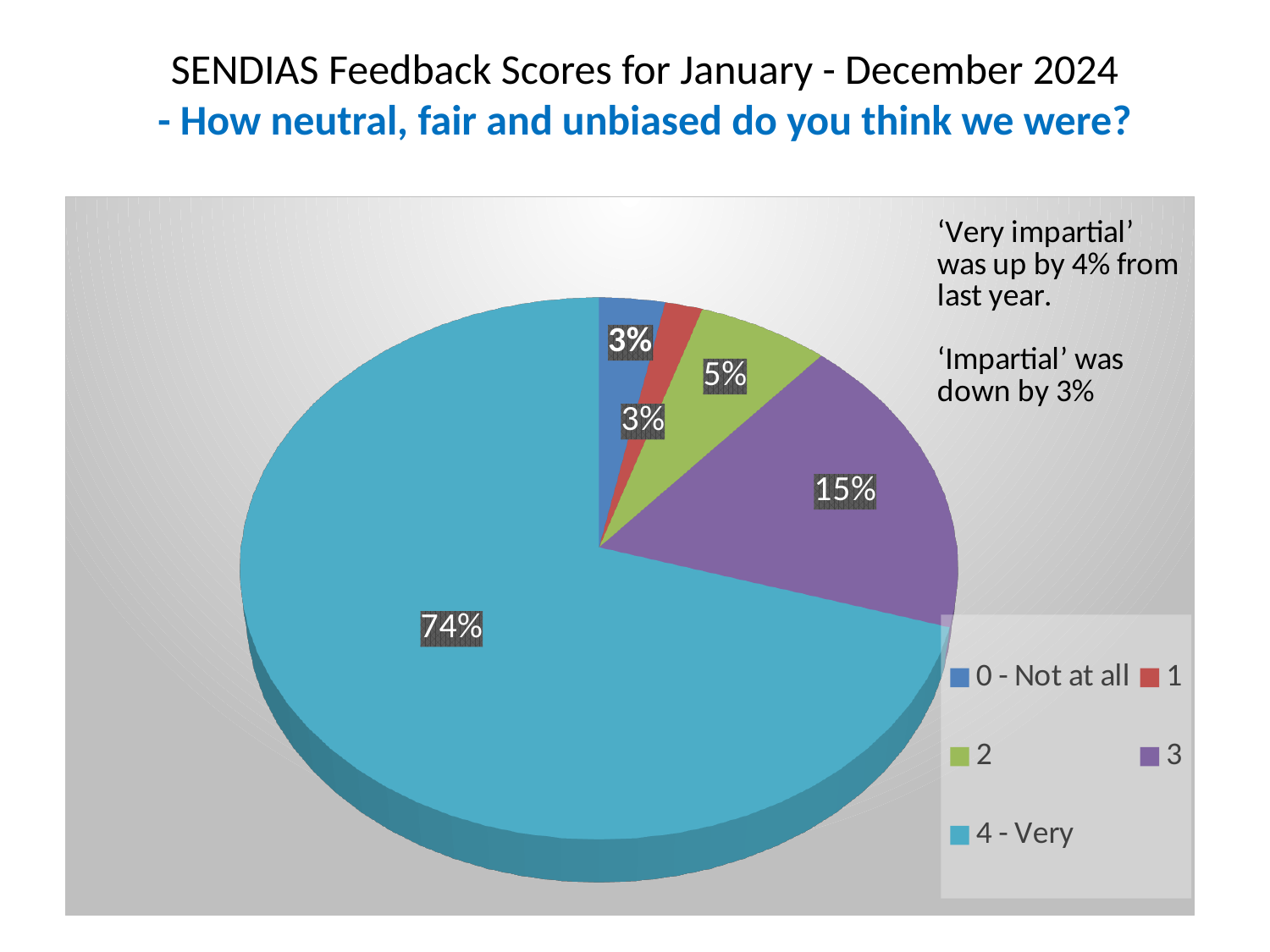
What kind of chart is shown on the slide? pie chart What is the difference in percentage points between '4 - Very' and '3'? 59 Which colour represents '4 - Very' in the chart? teal/light blue What percentage of responses were '4 - Very'? 74% Which category has the largest share of the pie? 4 - Very What percentage of responses were '2'? 5% What is the combined share of '3' and '4 - Very'? 89% Which is larger, the share for '2' or the share for '3'? 3 What percentage of responses were '0 - Not at all'? 3% According to the text on the slide, by how much was 'Very impartial' up from last year? 4% How many categories does the legend list? 5 What percentage of responses were '3'? 15%